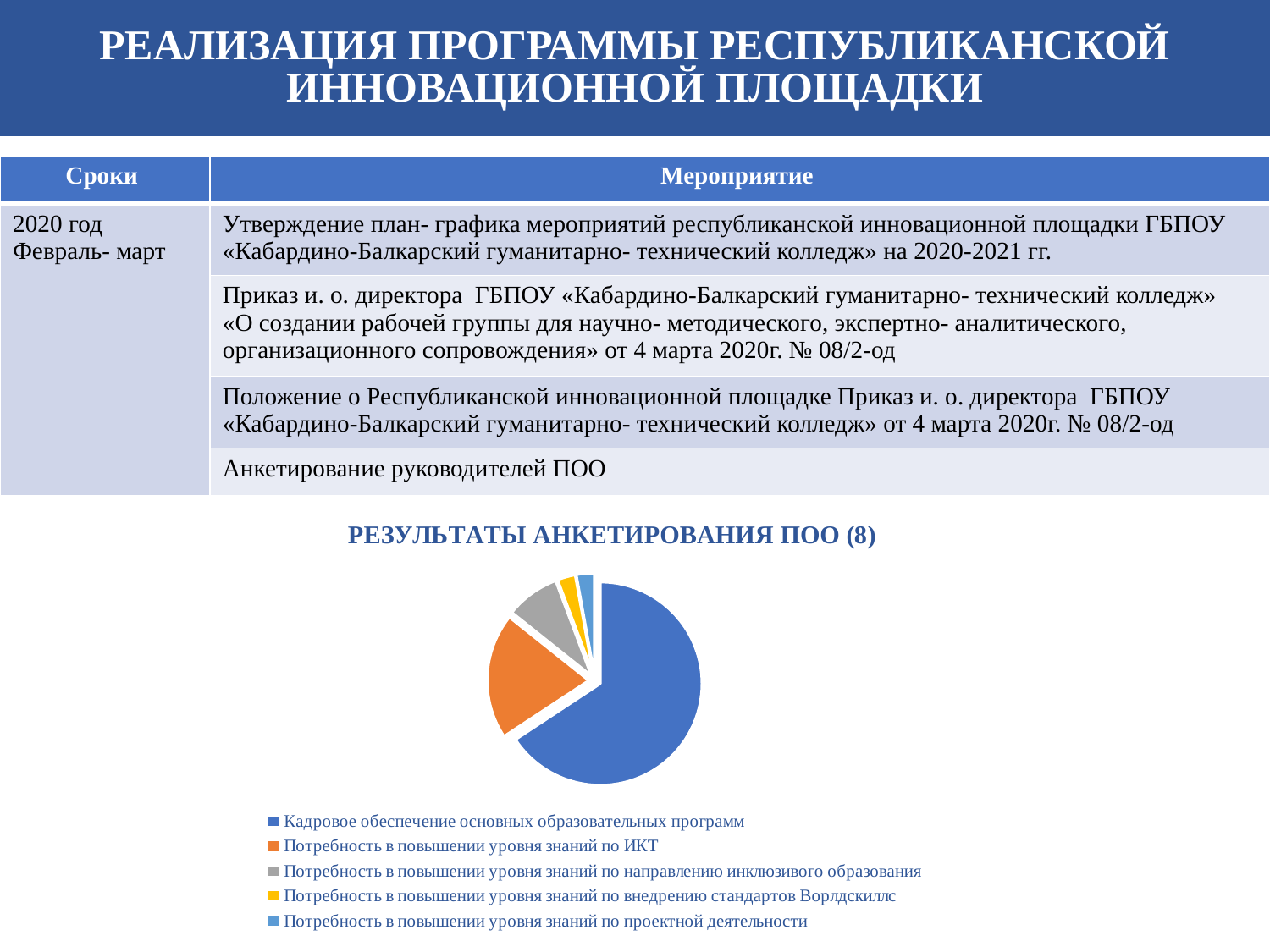
Which slice is larger: "Кадровое обеспечение основных образовательных программ" or "Потребность в повышении уровня знаний по ИКТ"? Кадровое обеспечение основных образовательных программ Which slice is larger: "Потребность в повышении уровня знаний по ИКТ" or "Потребность в повышении уровня знаний по направлению инклюзивого образования"? Потребность в повышении уровня знаний по ИКТ What is the title of the chart? РЕЗУЛЬТАТЫ АНКЕТИРОВАНИЯ ПОО (8) How many categories does the legend of the pie chart list? 5 What kind of chart is shown on the slide? pie chart Which slice is larger: "Потребность в повышении уровня знаний по направлению инклюзивого образования" or "Потребность в повышении уровня знаний по внедрению стандартов Ворлдскиллс"? Потребность в повышении уровня знаний по направлению инклюзивого образования Which category has the largest slice of the pie? Кадровое обеспечение основных образовательных программ Which category is shown in orange in the pie chart? Потребность в повышении уровня знаний по ИКТ Does the largest slice of the pie take up more or less than half of the pie? more